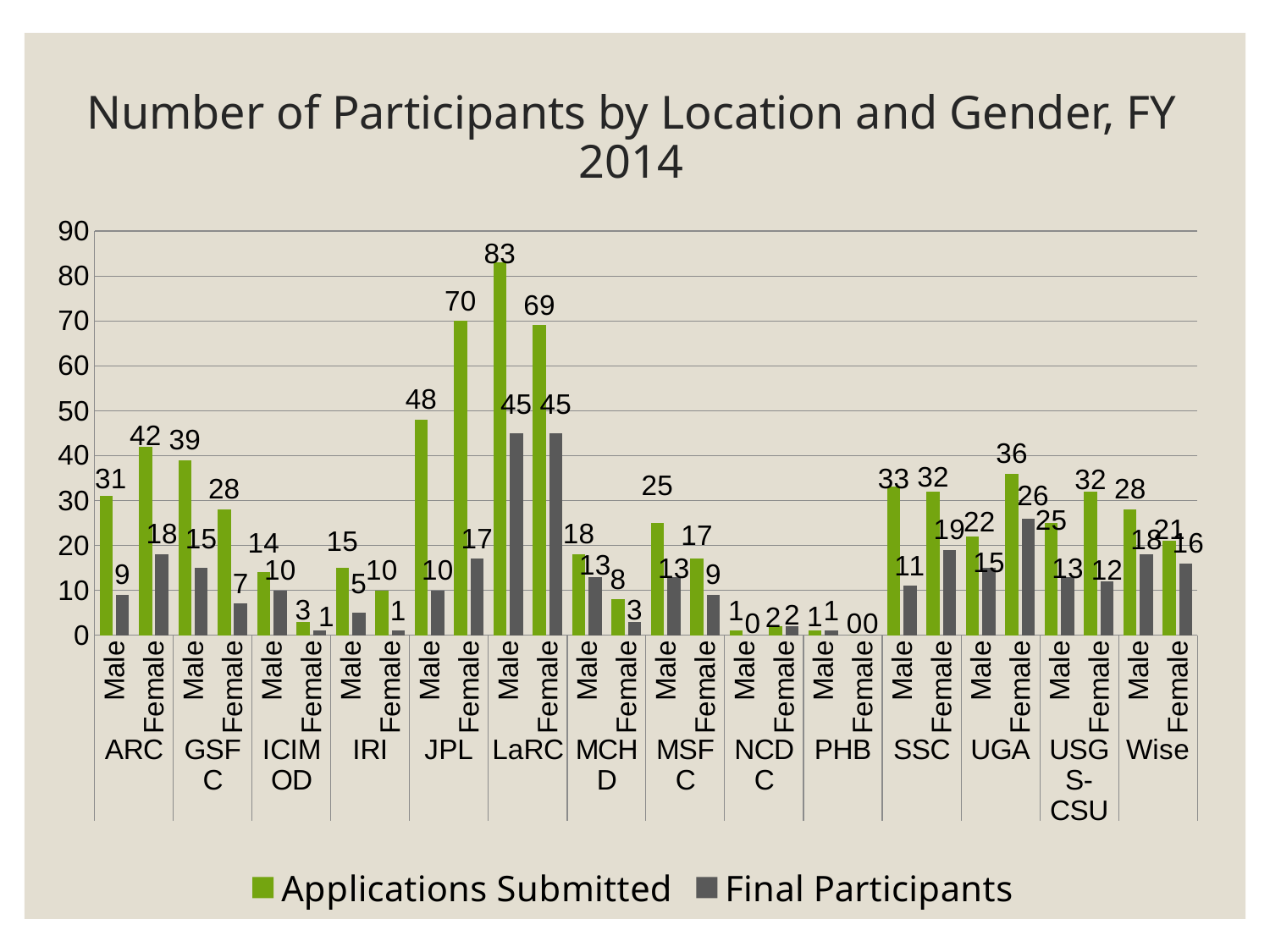
Which location and gender group has the highest number of applications submitted? LaRC Male What kind of chart is shown on the slide? Bar chart What is the difference between applications submitted and final participants for males at JPL? 38 How many final participants were there among females at UGA? 26 How many applications were submitted by females at JPL? 70 How many series does the legend list? 2 What is the title of the chart? Number of Participants by Location and Gender, FY 2014 How many applications were submitted by males at LaRC? 83 How many locations are shown on the x axis? 14 Which is larger: applications submitted by females at ARC or by males at GSFC? Females at ARC What is the difference between applications submitted by males and females at LaRC? 14 How many final participants were there among males at SSC? 11